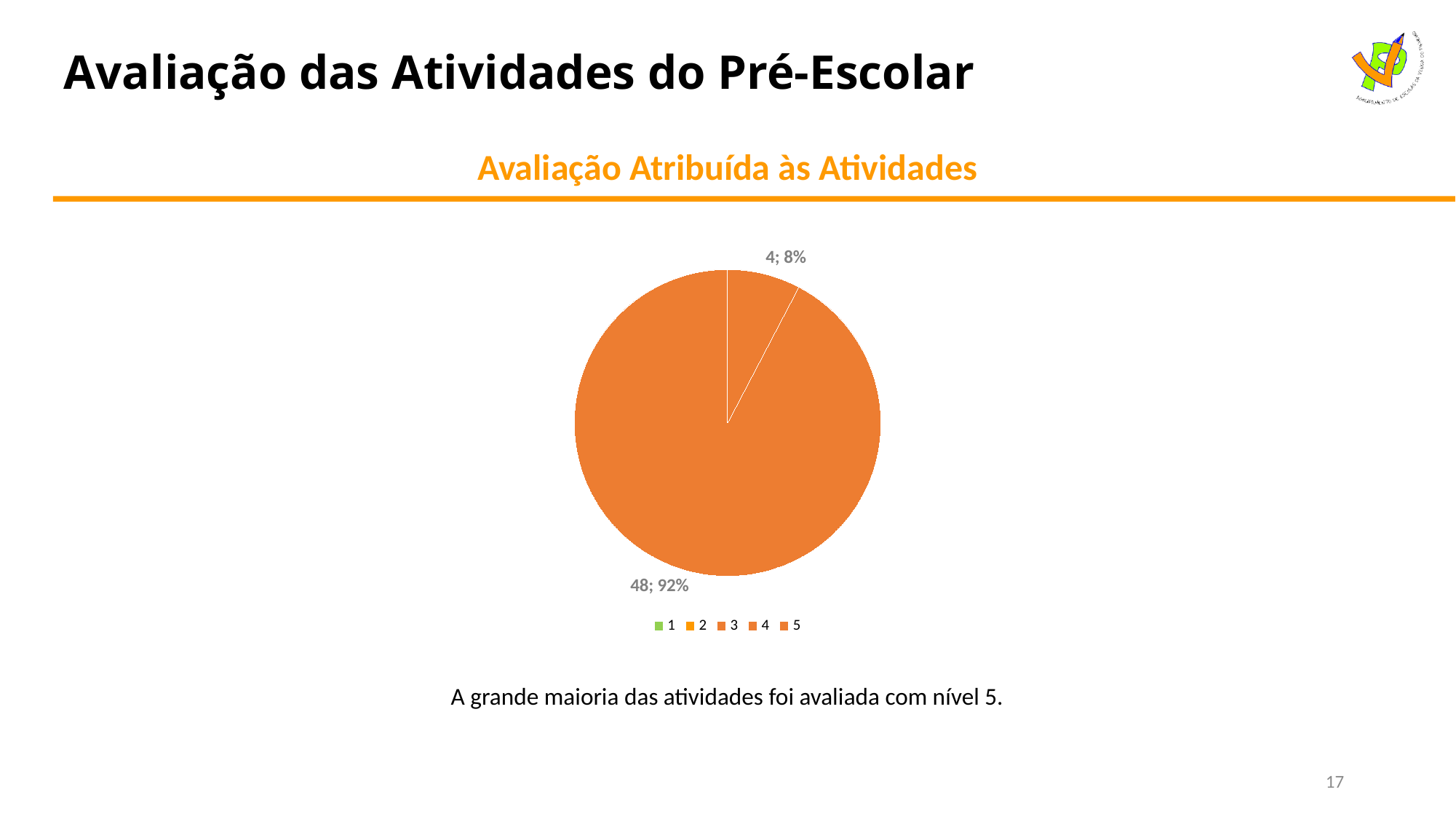
What kind of chart is shown on the slide? pie chart Which slice is larger: the one labelled 48 or the one labelled 4? the one labelled 48 What is the difference in count between the largest slice (48) and the smallest visible slice (4)? 44 What is the title of the chart? Avaliação Atribuída às Atividades According to the slide text, which level was assigned to the great majority of activities? nível 5 What is the count shown on the smallest visible slice of the pie chart? 4 What share of the pie does the smallest visible slice represent? 8% What is the total count across the two labelled slices of the pie chart? 52 How many slices with data labels are visible in the pie chart? 2 What share of the pie does the largest slice represent? 92% What is the count shown on the largest slice of the pie chart? 48 How many entries does the chart legend list? 5